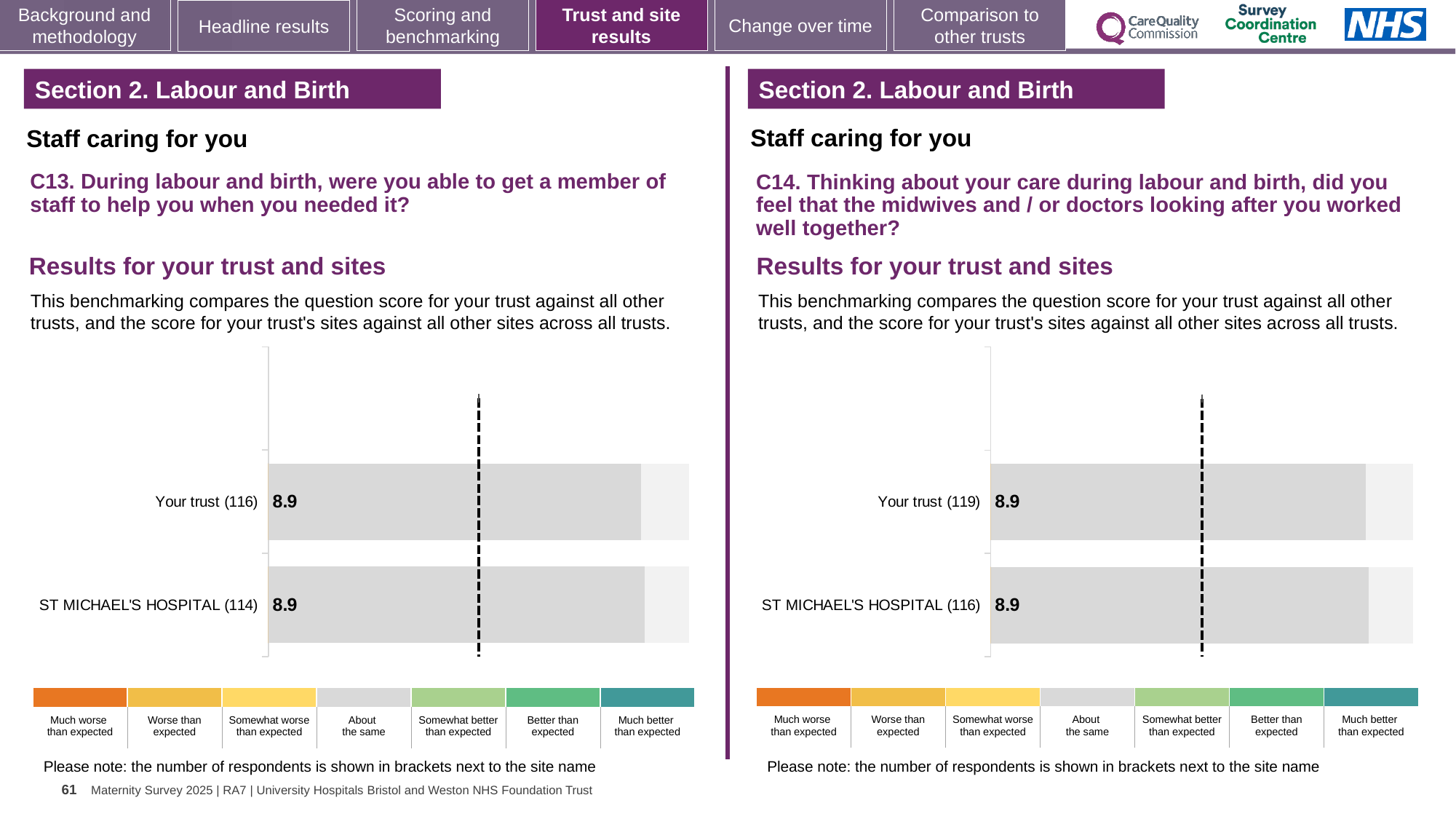
On the left chart (C13), how many respondents are shown in brackets for ST MICHAEL'S HOSPITAL? 114 On the left chart (C13), what is the difference between the score for Your trust and the score for ST MICHAEL'S HOSPITAL? 0 On the left chart (C13), how many respondents are shown in brackets for Your trust? 116 On the right chart (C14), how many respondents are shown in brackets for ST MICHAEL'S HOSPITAL? 116 On the left chart (C13), what is the score for Your trust? 8.9 On the right chart (C14), what is the score for ST MICHAEL'S HOSPITAL? 8.9 What kind of chart is the right chart (C14)? bar chart On the left chart (C13), what is the score for ST MICHAEL'S HOSPITAL? 8.9 On the right chart (C14), how many respondents are shown in brackets for Your trust? 119 On the left chart (C13), how many bars are plotted? 2 On the right chart (C14), what is the score for Your trust? 8.9 On the right chart (C14), how many categories does the colour legend below the chart list? 7